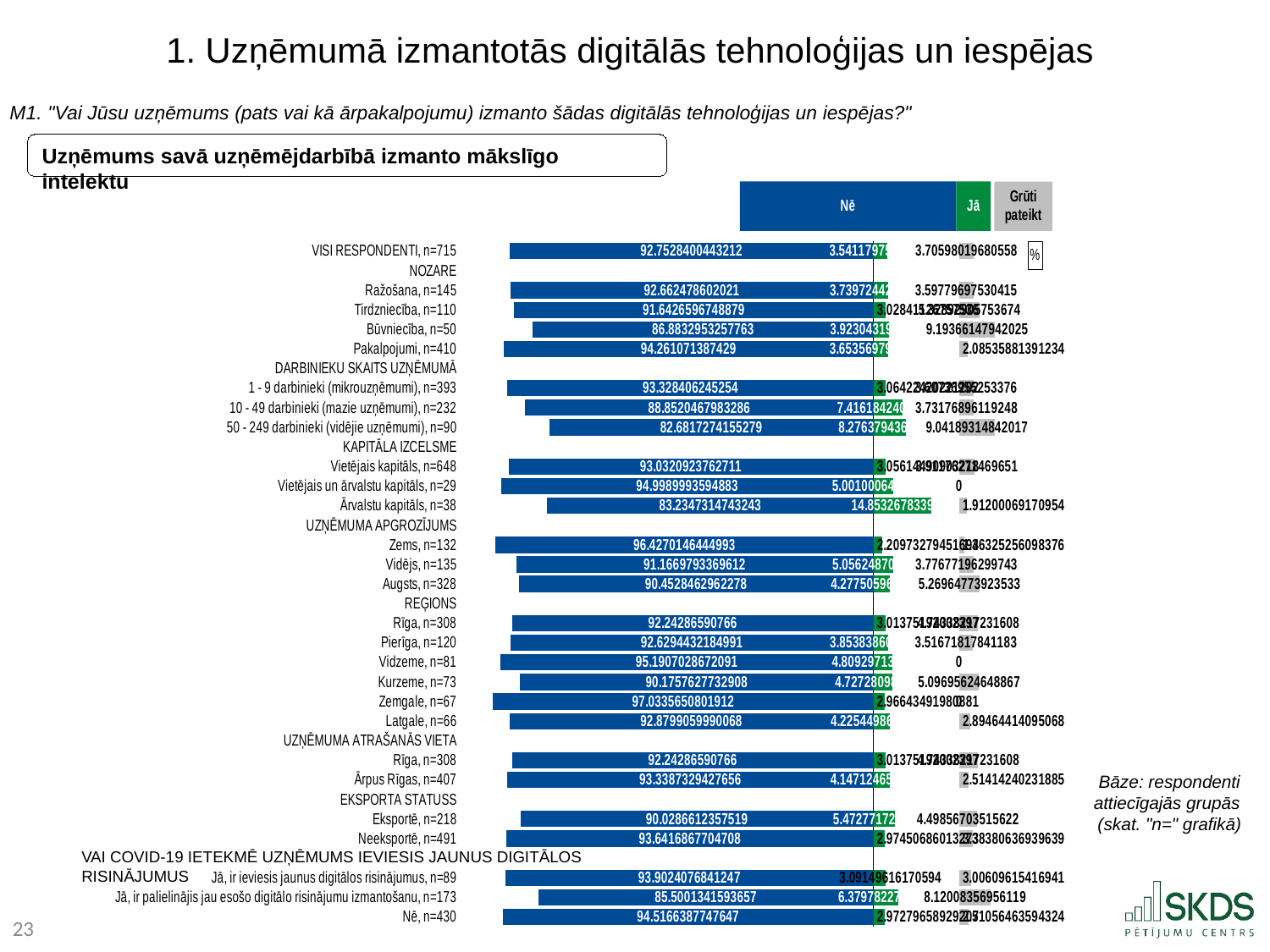
What colour represents the "Jā" series in the chart? Green What is the "Nē" value for Būvniecība, n=50? 86.8832953257763 What kind of chart is shown on the slide? Stacked horizontal bar chart Is the "Nē" value for Ārvalstu kapitāls, n=38 greater or less than 90? less How many series does the legend list? 3 Which group has the highest "Nē" value? Zemgale, n=67 What is the "Nē" value for VISI RESPONDENTI, n=715? 92.7528400443212 Which has the larger "Nē" value: Būvniecība, n=50 or Pakalpojumi, n=410? Pakalpojumi, n=410 What are the three series named in the legend? Nē, Jā, Grūti pateikt What is the "Grūti pateikt" value for Vidzeme, n=81? 0 What is the "Grūti pateikt" value for Būvniecība, n=50? 9.19366147942025 What is the difference between the "Nē" values for Zemgale, n=67 and Kurzeme, n=73? 6.8578023069004